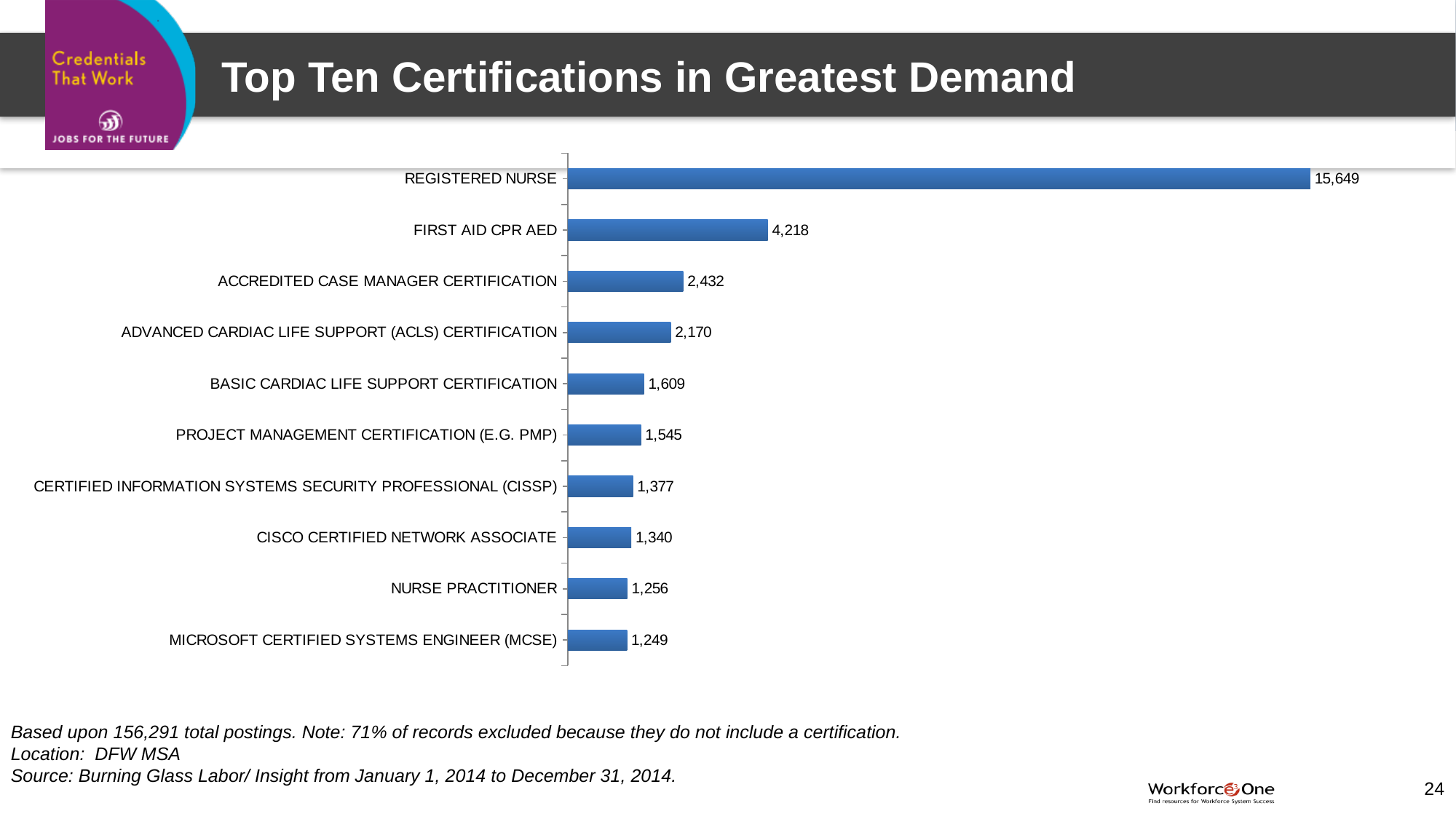
How many certifications are shown in the chart? 10 What is the difference between the values for REGISTERED NURSE and FIRST AID CPR AED? 11,431 Which certification has the highest value? REGISTERED NURSE What is the value for FIRST AID CPR AED? 4,218 What is the value for CISCO CERTIFIED NETWORK ASSOCIATE? 1,340 What kind of chart is shown on the slide? Bar chart What is the title of the slide? Top Ten Certifications in Greatest Demand What is the difference between the values for ACCREDITED CASE MANAGER CERTIFICATION and ADVANCED CARDIAC LIFE SUPPORT (ACLS) CERTIFICATION? 262 What is the value for NURSE PRACTITIONER? 1,256 Which is larger, the value for BASIC CARDIAC LIFE SUPPORT CERTIFICATION or PROJECT MANAGEMENT CERTIFICATION (E.G. PMP)? BASIC CARDIAC LIFE SUPPORT CERTIFICATION What is the value for REGISTERED NURSE? 15,649 Which certification has the lowest value? MICROSOFT CERTIFIED SYSTEMS ENGINEER (MCSE)